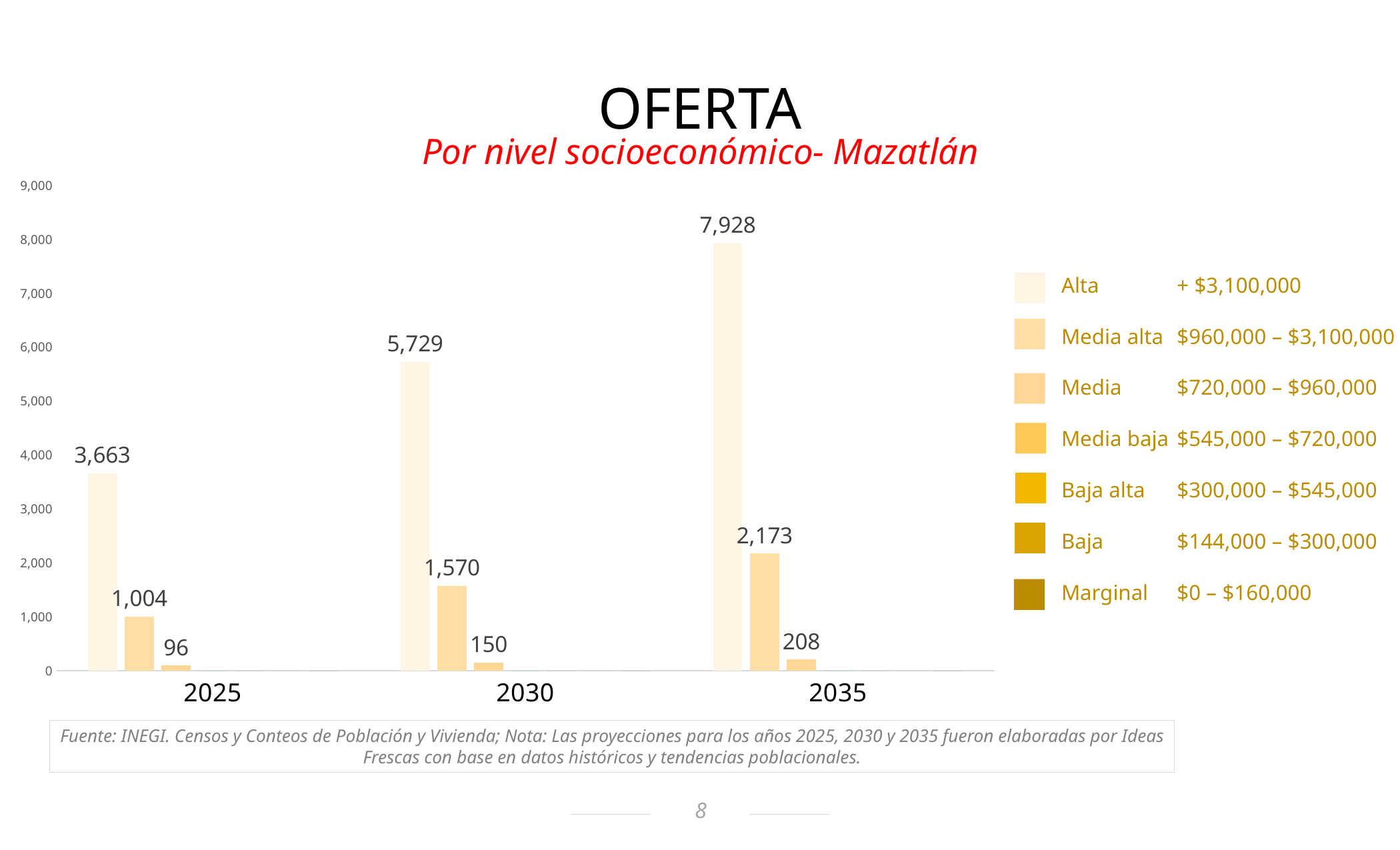
In which year is the Media value lowest? 2025 What kind of chart is shown on the slide? Bar chart How many years are shown on the x axis? 3 What is the value for Alta in 2035? 7,928 What is the difference between the Alta values for 2035 and 2030? 2,199 Do the Alta values rise or fall from 2025 to 2035? Rise In which year is the Alta value highest? 2035 What is the value for Media alta in 2030? 1,570 What is the value for Media alta in 2025? 1,004 How many series does the legend list? 7 What is the value for Media in 2025? 96 Which is larger: Media alta in 2035 or Media alta in 2030? Media alta in 2035